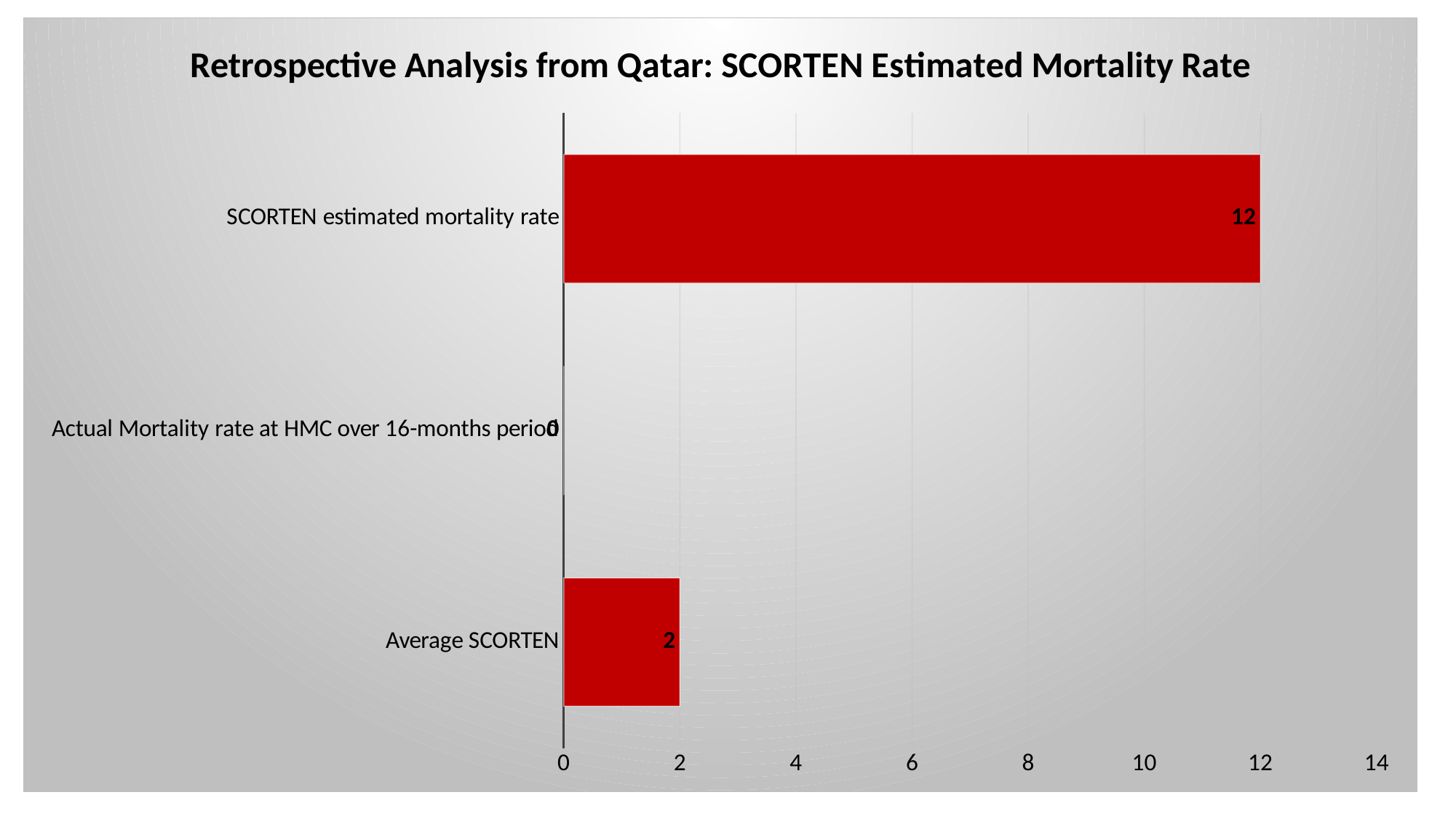
What is the title of the chart? Retrospective Analysis from Qatar: SCORTEN Estimated Mortality Rate Which category has the lowest value? Actual Mortality rate at HMC over 16-months period What colour are the bars in the chart? red What is the value for SCORTEN estimated mortality rate? 12 What kind of chart is shown on the slide? bar chart What is the value for Actual Mortality rate at HMC over 16-months period? 0 Is the value for SCORTEN estimated mortality rate greater or less than 10? greater Which is larger, the SCORTEN estimated mortality rate or the Average SCORTEN? SCORTEN estimated mortality rate How many categories are shown in the chart? 3 What is the difference between the SCORTEN estimated mortality rate and the Average SCORTEN? 10 What is the value for Average SCORTEN? 2 Which category has the highest value? SCORTEN estimated mortality rate